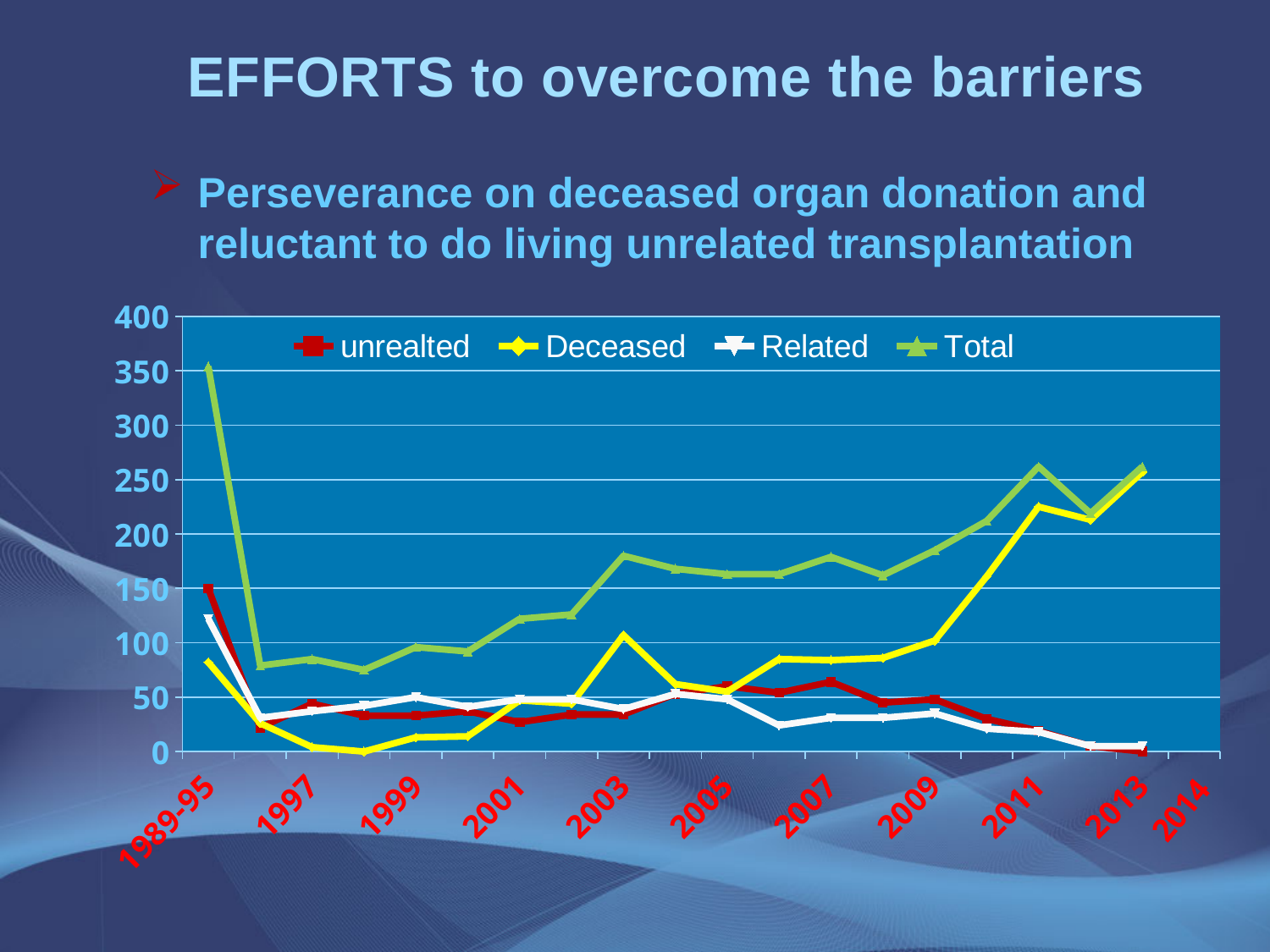
Which is larger at 2011: the Deceased value or the Related value? Deceased How many year labels are shown on the x axis of the chart? 11 Is the value of the Deceased series at 2011 greater or less than 200? greater In which year label does the Total series reach its highest value? 1989-95 What kind of chart is shown on the slide? line chart How many series does the chart legend list? 4 Is the value of the Total series at 1997 greater or less than 100? less Which is larger for the Total series: the value at 1989-95 or the value at 2011? 1989-95 Which series is drawn in green in the chart? Total Is the value of the Total series at 1989-95 greater or less than 300? greater Does the Deceased series rise or fall between 2009 and 2011? rise